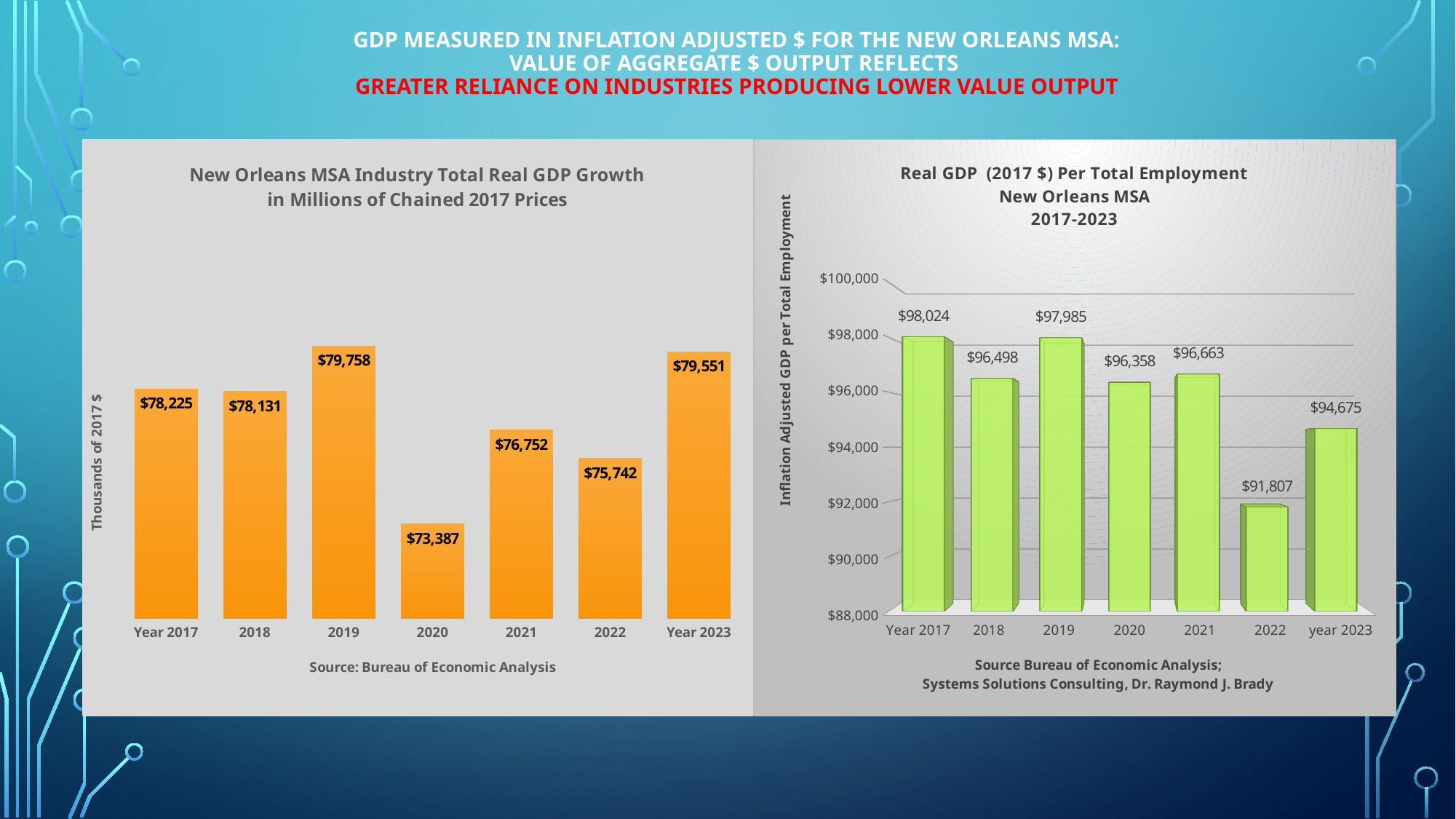
In the right chart (Real GDP (2017 $) Per Total Employment), what is the y-axis label? Inflation Adjusted GDP per Total Employment In the right chart (Real GDP (2017 $) Per Total Employment), is the value for 2020 greater or less than $96,000? greater In the left chart (New Orleans MSA Industry Total Real GDP Growth), what is the difference between the 2019 value and the 2020 value? $6,371 In the left chart (New Orleans MSA Industry Total Real GDP Growth), what is the value for 2020? $73,387 In the left chart (New Orleans MSA Industry Total Real GDP Growth), how many years are plotted? 7 In the left chart (New Orleans MSA Industry Total Real GDP Growth), what kind of chart is it? Bar chart In the left chart (New Orleans MSA Industry Total Real GDP Growth), which year has the lowest value? 2020 In the right chart (Real GDP (2017 $) Per Total Employment), which is larger, the value for 2018 or the value for 2021? 2021 In the right chart (Real GDP (2017 $) Per Total Employment), which year has the lowest value? 2022 In the right chart (Real GDP (2017 $) Per Total Employment), what is the difference between the Year 2017 value and the year 2023 value? $3,349 In the right chart (Real GDP (2017 $) Per Total Employment), what is the value for 2022? $91,807 In the left chart (New Orleans MSA Industry Total Real GDP Growth), which year has the highest value? 2019